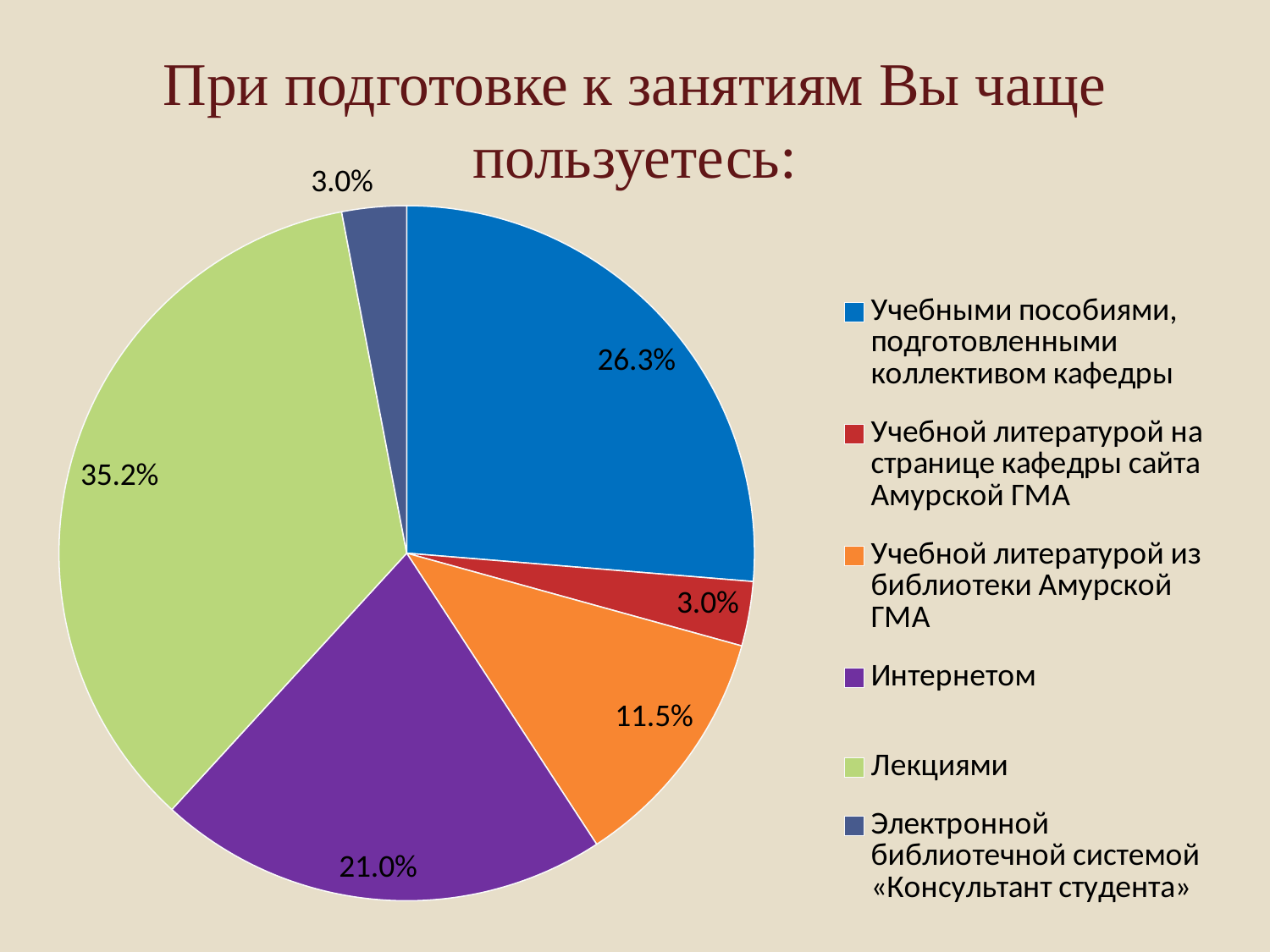
What kind of chart is shown on the slide? Pie chart What is the value shown for "Интернетом"? 21.0% What share of the pie does "Лекциями" represent? 35.2% How many categories does the pie chart have? 6 What colour is the slice for "Интернетом"? Purple What is the value for "Учебными пособиями, подготовленными коллективом кафедры"? 26.3% What is the difference between the shares for "Лекциями" and "Интернетом"? 14.2% Which category has the largest slice of the pie? Лекциями Which is larger: the share for "Учебными пособиями, подготовленными коллективом кафедры" or the share for "Интернетом"? Учебными пособиями, подготовленными коллективом кафедры What is the title of the chart? При подготовке к занятиям Вы чаще пользуетесь: What percentage is shown for "Учебной литературой из библиотеки Амурской ГМА"? 11.5% What is the difference between the shares for "Учебными пособиями, подготовленными коллективом кафедры" and "Учебной литературой из библиотеки Амурской ГМА"? 14.8%